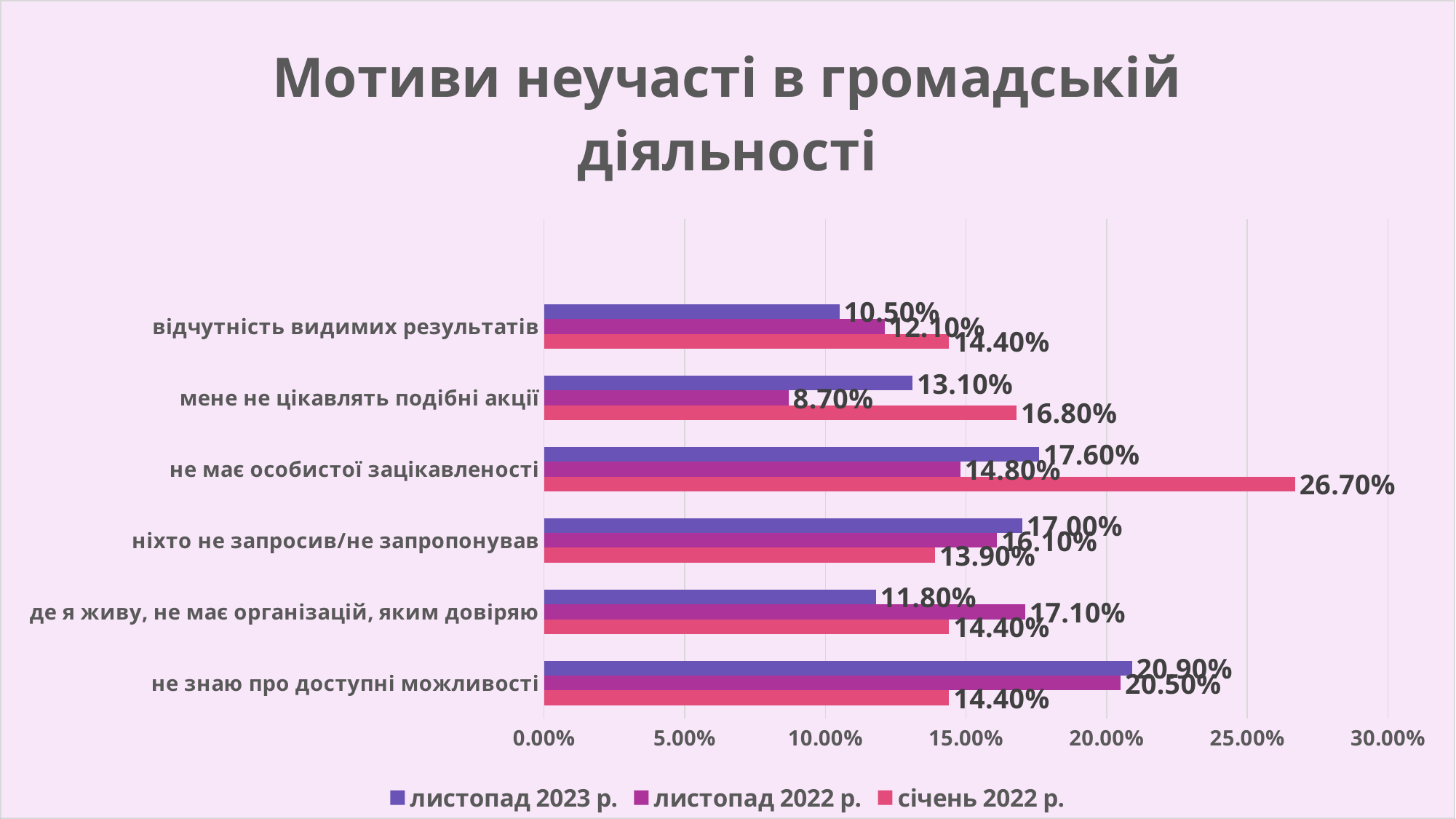
What kind of chart is shown on the slide? bar chart Which category has the lowest value in the "листопад 2023 р." series? відчутність видимих результатів Is the "листопад 2023 р." value for "не знаю про доступні можливості" greater or less than 20.00%? greater Which category has the highest value in the "січень 2022 р." series? не має особистої зацікавленості What is the difference between the "січень 2022 р." and "листопад 2023 р." values for "не має особистої зацікавленості"? 9.10% What is the value for "не знаю про доступні можливості" in the "листопад 2023 р." series? 20.90% What is the title of the chart? Мотиви неучасті в громадській діяльності What is the value for "мене не цікавлять подібні акції" in the "листопад 2022 р." series? 8.70% What is the value for "не має особистої зацікавленості" in the "січень 2022 р." series? 26.70% How many series does the legend list? 3 How many categories are shown on the chart? 6 For "де я живу, не має організацій, яким довіряю", which series has the larger value: "листопад 2023 р." or "листопад 2022 р."? листопад 2022 р.